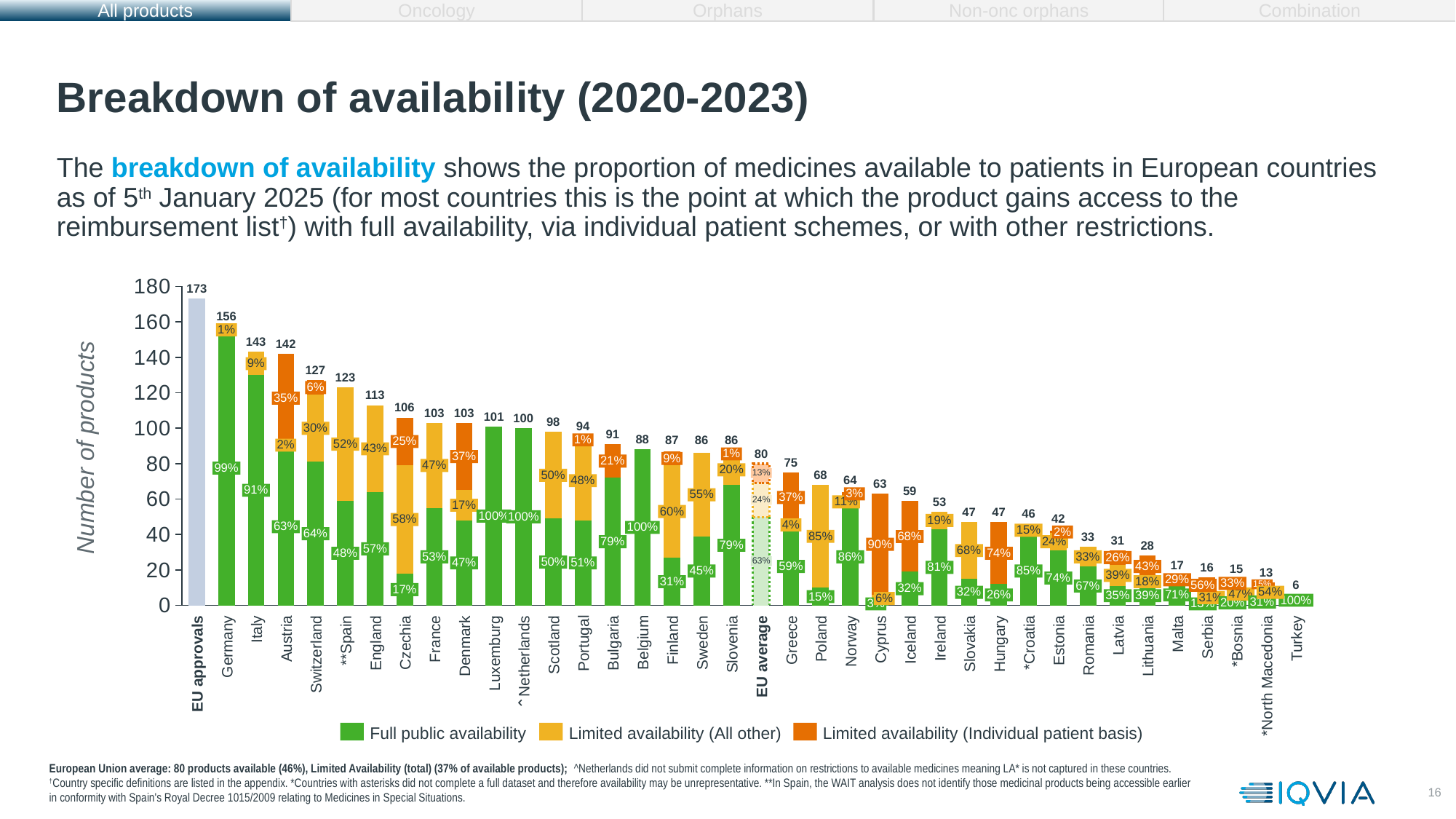
Is the total for Ireland greater or less than 60? less What kind of chart is shown on the slide? Stacked bar chart What is the difference between the totals for Germany and Italy? 13 How many series does the legend list? 3 What is the total number of products shown for Germany? 156 Do the bar totals rise or fall from left to right along the x axis? Fall What is the total number of products shown for the EU average bar? 80 Which bar has the highest total number of products? EU approvals What is the total number of products shown for France? 103 Which has a higher total number of products, Poland or Norway? Poland What percentage of Germany's bar is full public availability? 99% Which country has the lowest total number of products? Turkey